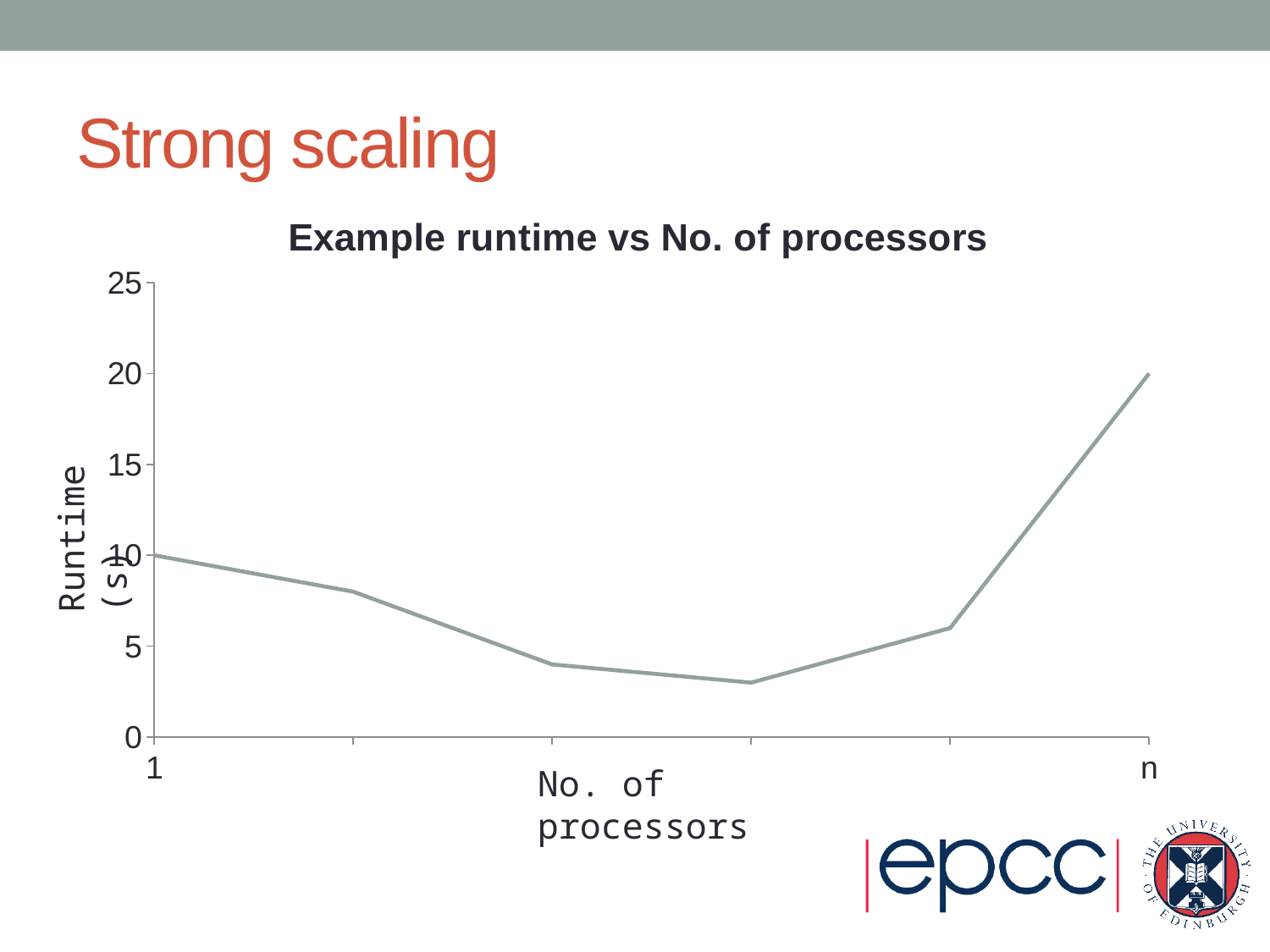
Is the runtime at the fifth plotted point greater or less than 5? greater What is the runtime when the number of processors is 1? 10 What is the difference between the runtime at n processors and the runtime at 1 processor? 10 Is the runtime at the second plotted point greater or less than 10? less What is the title of the chart? Example runtime vs No. of processors How does the runtime change as the number of processors increases from 1 to n? It falls at first, then rises What kind of chart is shown on the slide? line chart Which has the higher runtime: 1 processor or n processors? n processors Is the runtime at the fourth plotted point greater or less than 5? less What is the runtime when the number of processors is n? 20 What is the label of the y axis? Runtime (s) How many data points are plotted on the line? 6